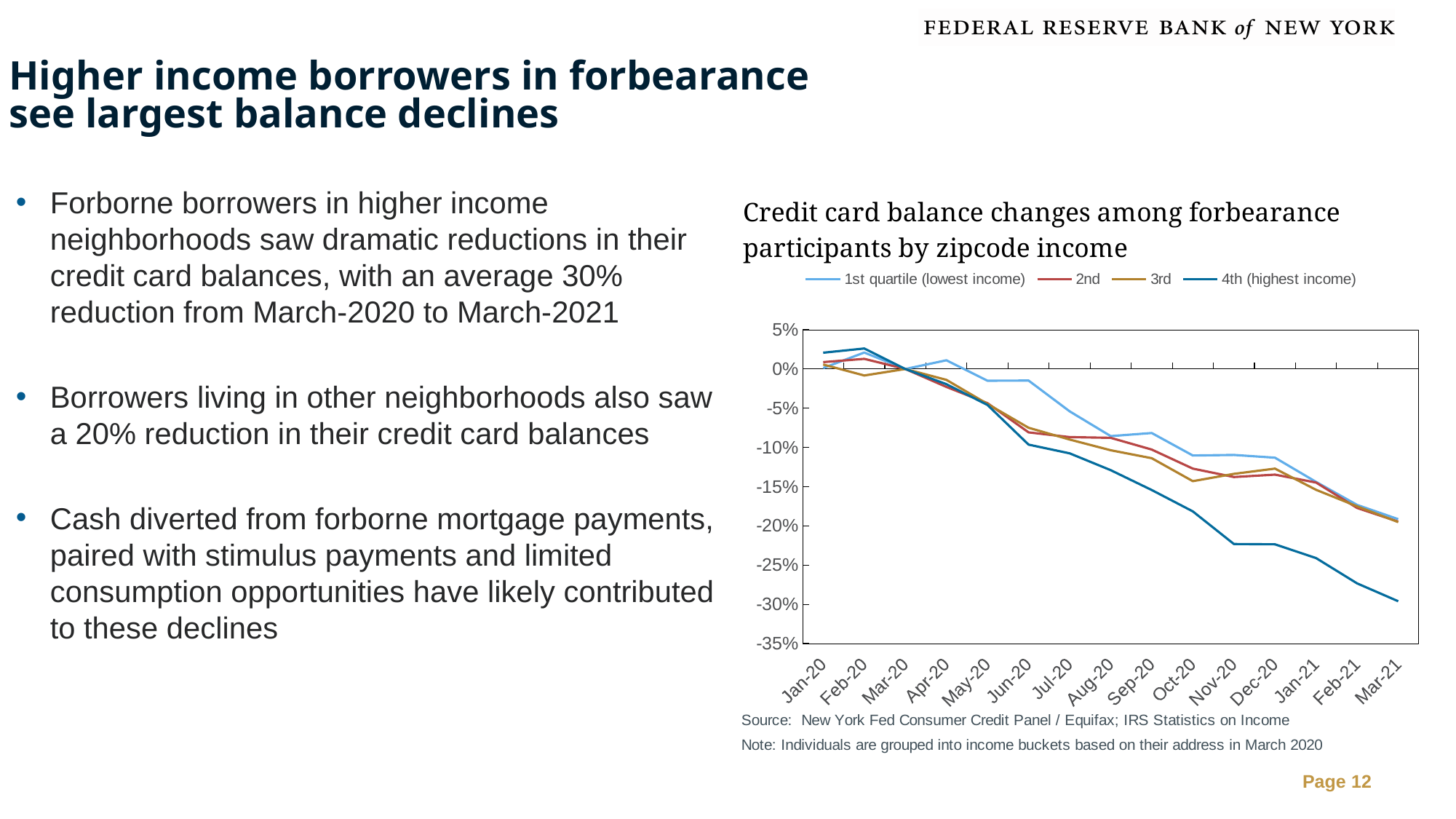
What kind of chart is shown on the slide? line chart What is the title of the chart? Credit card balance changes among forbearance participants by zipcode income Is the value for the 1st quartile (lowest income) in Oct-20 greater or less than -15%? greater Is the value for the 4th (highest income) quartile in Mar-21 greater or less than -25%? less Is the value for the 1st quartile (lowest income) in Jun-20 greater or less than -5%? greater Do the values for the 4th (highest income) quartile rise or fall from Mar-20 to Mar-21? fall Which series has the lowest value in Mar-21? 4th (highest income) What is the first month shown on the x axis of the chart? Jan-20 How many series does the chart legend list? 4 In Jul-20, which series has the higher value: the 1st quartile (lowest income) or the 4th (highest income)? 1st quartile (lowest income) How many months are shown along the x axis of the chart? 15